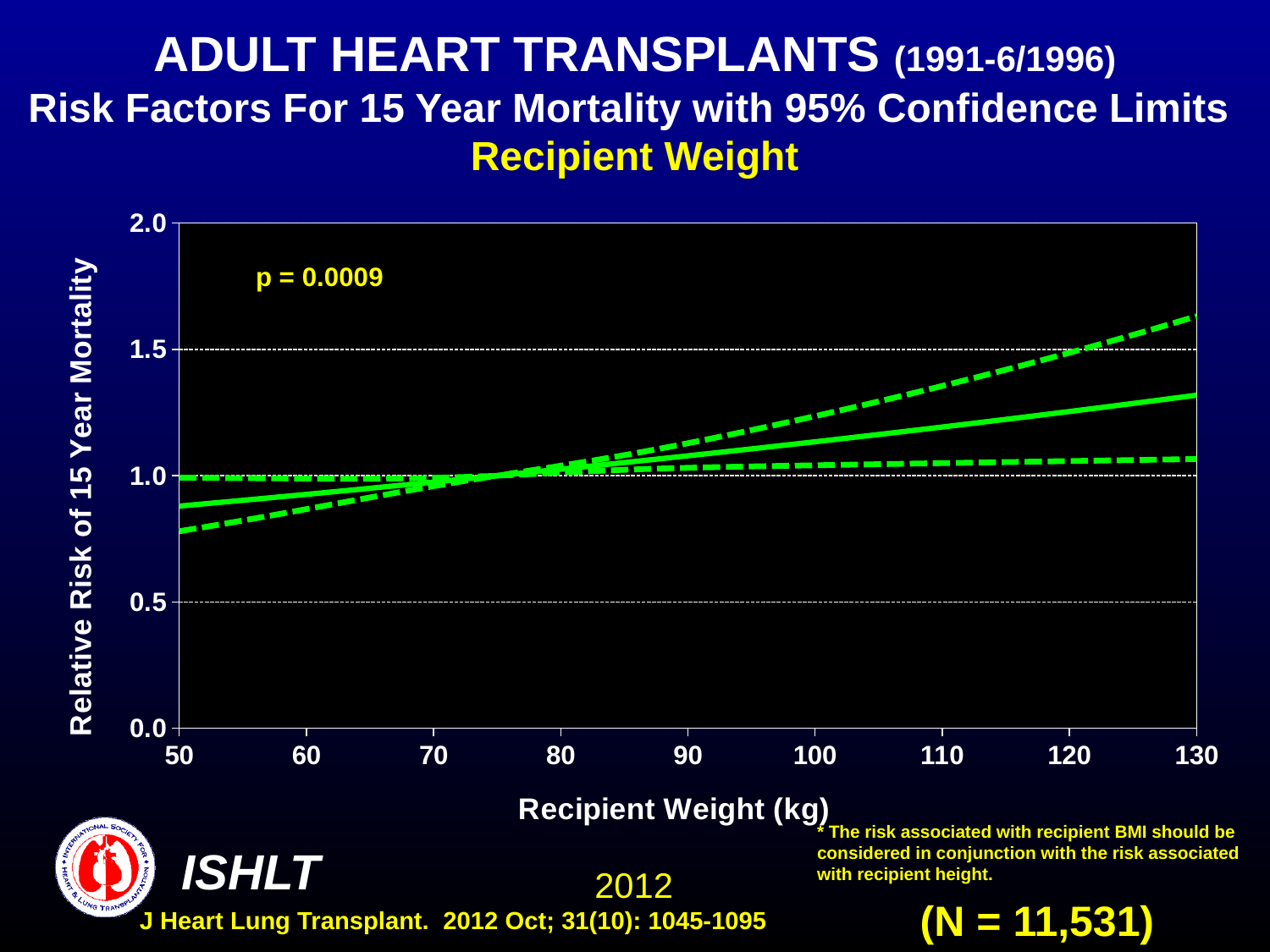
Is the relative risk on the solid line at a recipient weight of 130 kg greater or less than 1.0? greater How many lines are plotted on the chart? 3 Is the upper dashed confidence limit at a recipient weight of 100 kg greater or less than 1.5? less Is the upper dashed confidence limit at a recipient weight of 130 kg greater or less than 1.5? greater Does the solid line for relative risk of 15 year mortality rise or fall as recipient weight increases from 50 to 130 kg? rise What is the label of the x axis? Recipient Weight (kg) What kind of chart is shown on the slide? line chart What p-value is shown on the chart? p = 0.0009